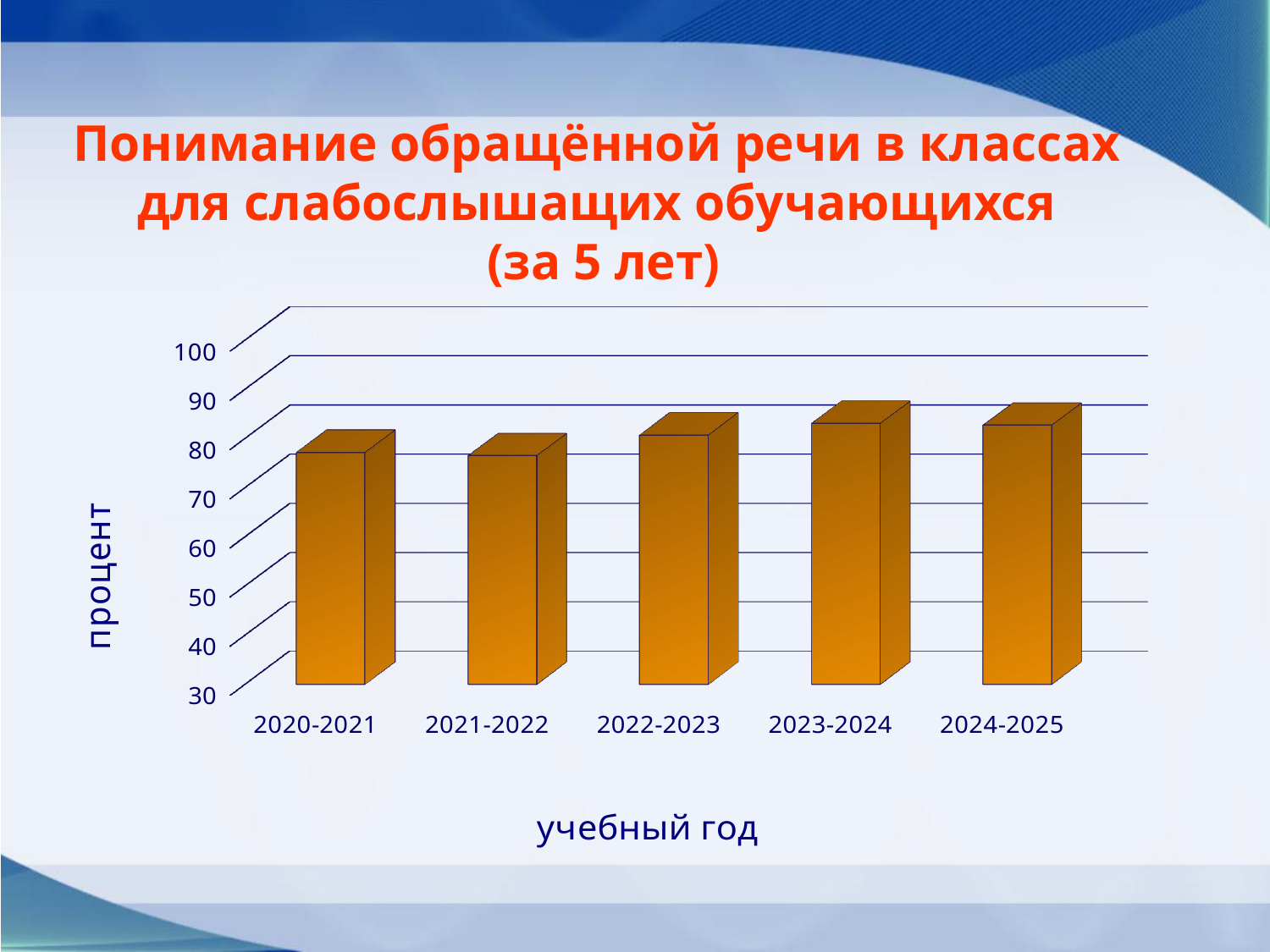
Is the value for 2021-2022 greater or less than 70? greater Is the value for 2020-2021 greater or less than 80? less Is the value for 2024-2025 greater or less than 80? greater How many academic years (categories) are shown on the x axis? 5 Which is larger, the value for 2020-2021 or the value for 2023-2024? 2023-2024 What kind of chart is shown on the slide? bar chart What is the label of the horizontal axis? учебный год What is the label of the vertical axis? процент Which is larger, the value for 2021-2022 or the value for 2022-2023? 2022-2023